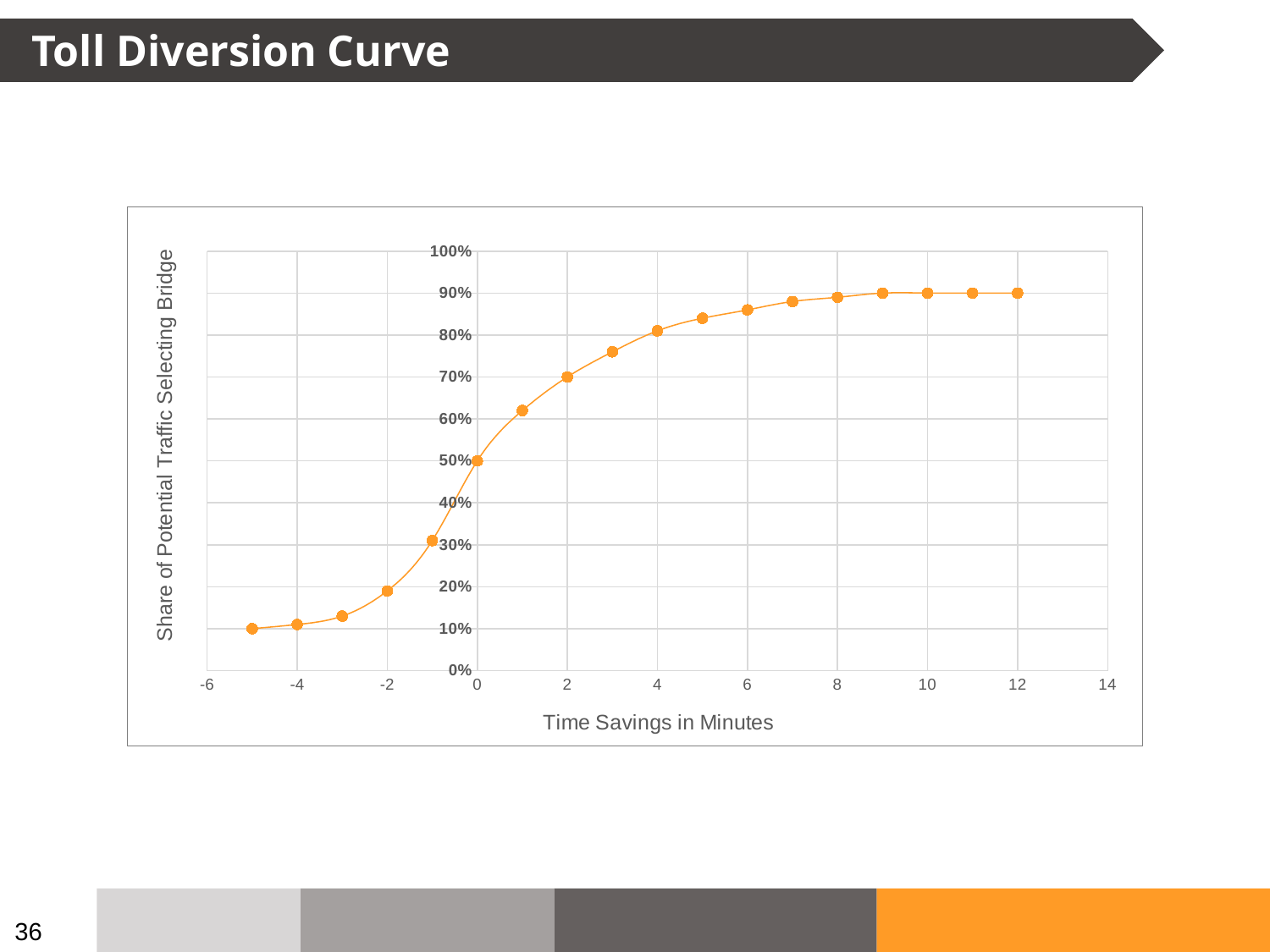
Is the share at -3 minutes of time savings greater or less than 20%? less Which has a higher share of traffic selecting the bridge: 2 minutes or -2 minutes of time savings? 2 minutes What is the share of potential traffic selecting the bridge at 2 minutes of time savings? 70% What type of chart is shown on the slide? line chart What is the share of potential traffic selecting the bridge at 12 minutes of time savings? 90% What is the label of the x axis? Time Savings in Minutes Is the share at 5 minutes of time savings greater or less than 80%? greater What is the title of the chart? Toll Diversion Curve Does the share of potential traffic selecting the bridge rise or fall as time savings increase? rise At which time savings value is the share of potential traffic selecting the bridge lowest? -5 What is the share of potential traffic selecting the bridge at 0 minutes of time savings? 50% What is the share of potential traffic selecting the bridge at -5 minutes of time savings? 10%